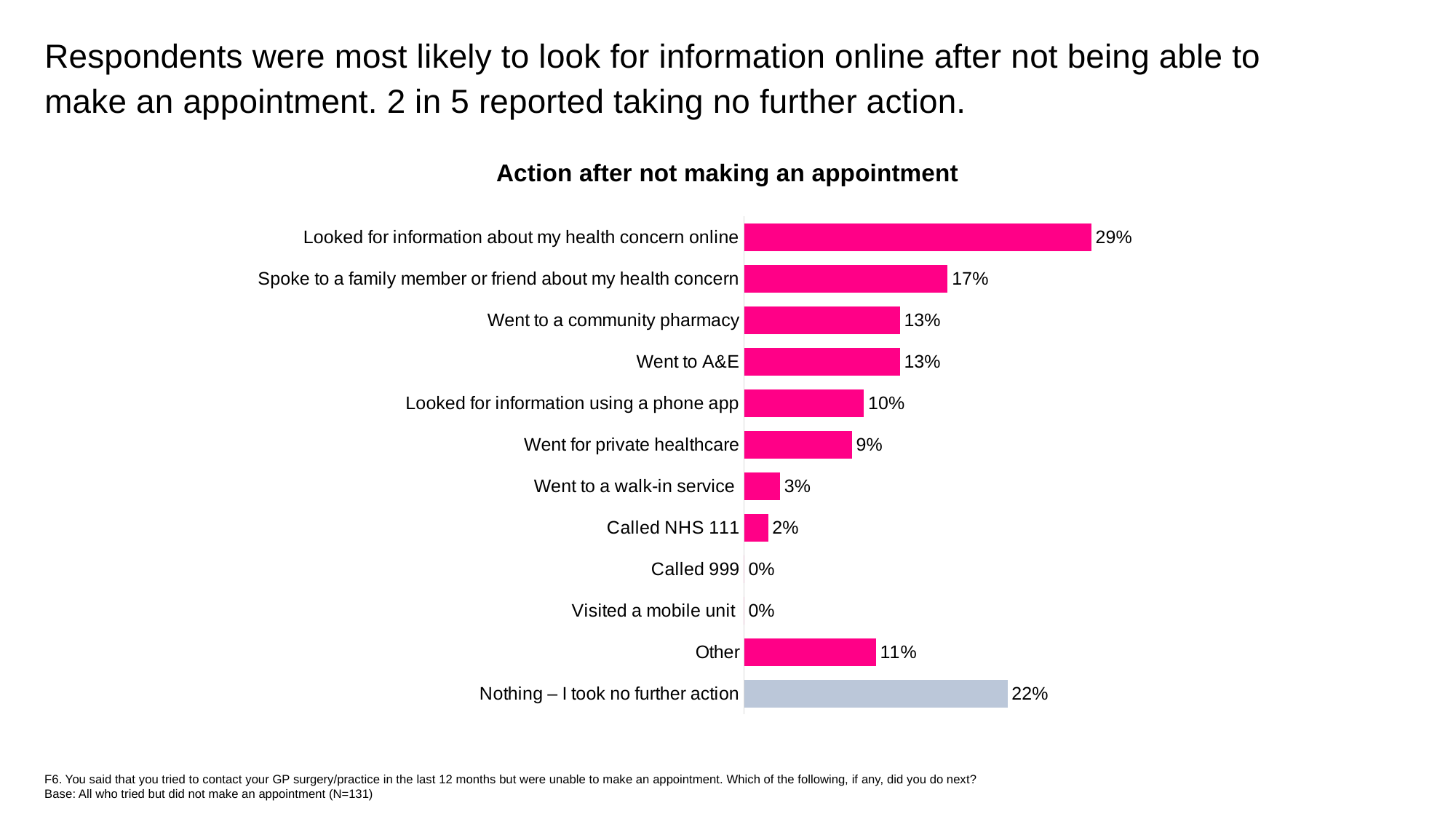
How many categories are shown in the chart? 12 How many categories have a value of 0%? 2 What is the value for 'Nothing – I took no further action'? 22% What is the difference between 'Nothing – I took no further action' and 'Other'? 11% What percentage of respondents went for private healthcare? 9% What type of chart is shown on the slide? Bar chart What is the difference between 'Looked for information about my health concern online' and 'Spoke to a family member or friend about my health concern'? 12% Which action has the highest percentage? Looked for information about my health concern online What is the title of the chart? Action after not making an appointment Which is larger: 'Went to a community pharmacy' or 'Looked for information using a phone app'? Went to a community pharmacy What is the value for 'Called NHS 111'? 2% What percentage of respondents looked for information about their health concern online? 29%